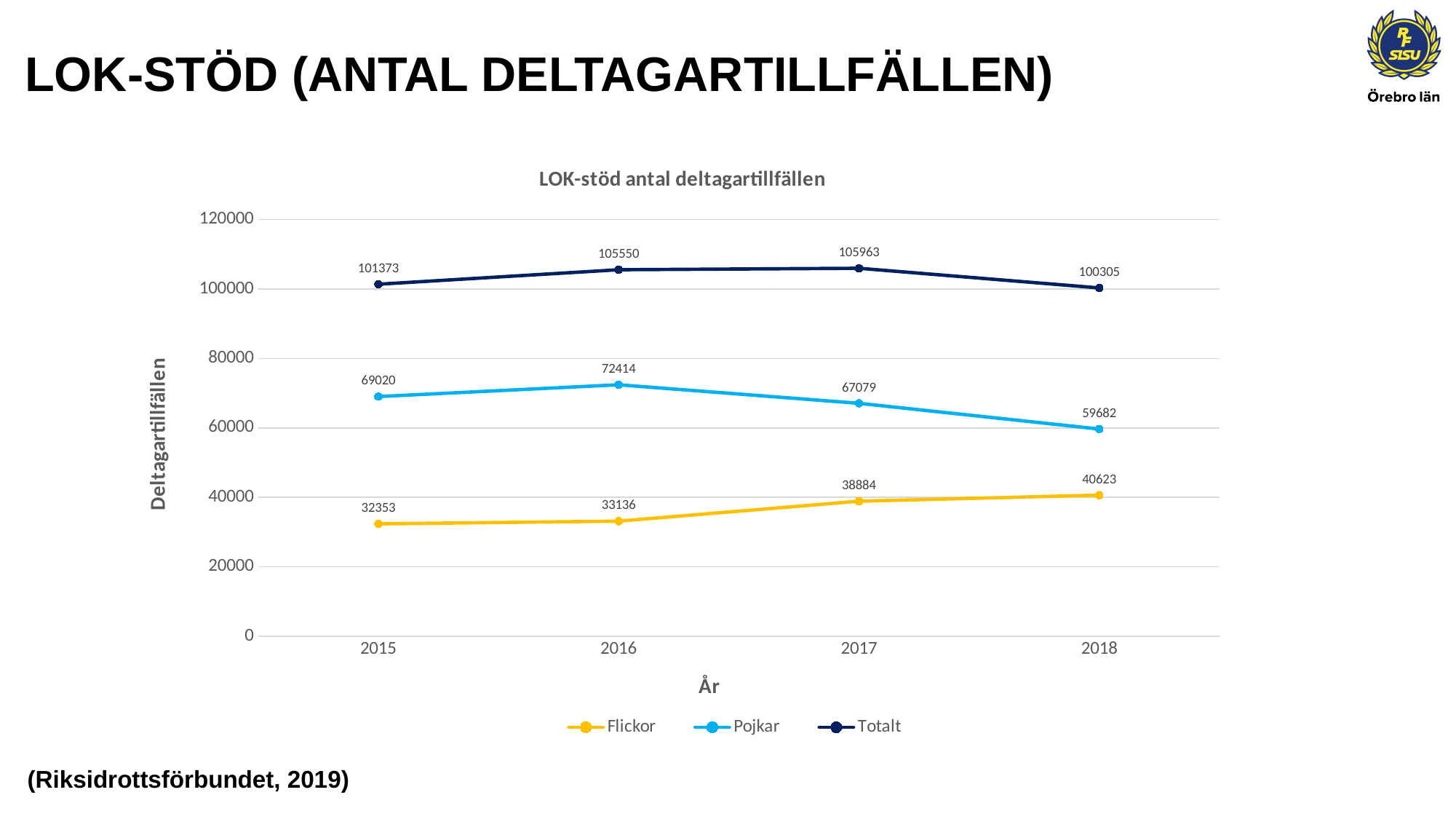
In which year is the Pojkar series lowest? 2018 Does the Flickor series rise or fall from 2015 to 2018? rise Which is larger, the Flickor value in 2015 or the Flickor value in 2018? 2018 How many years are shown on the x axis? 4 How many series does the legend list? 3 In which year is the Totalt series highest? 2017 Is the value for Pojkar in 2018 greater or less than 60000? less What kind of chart is shown? line chart What is the value for Pojkar in 2016? 72414 What is the value for Flickor in 2018? 40623 What is the difference between the Pojkar and Flickor values in 2017? 28195 What is the value for Totalt in 2015? 101373